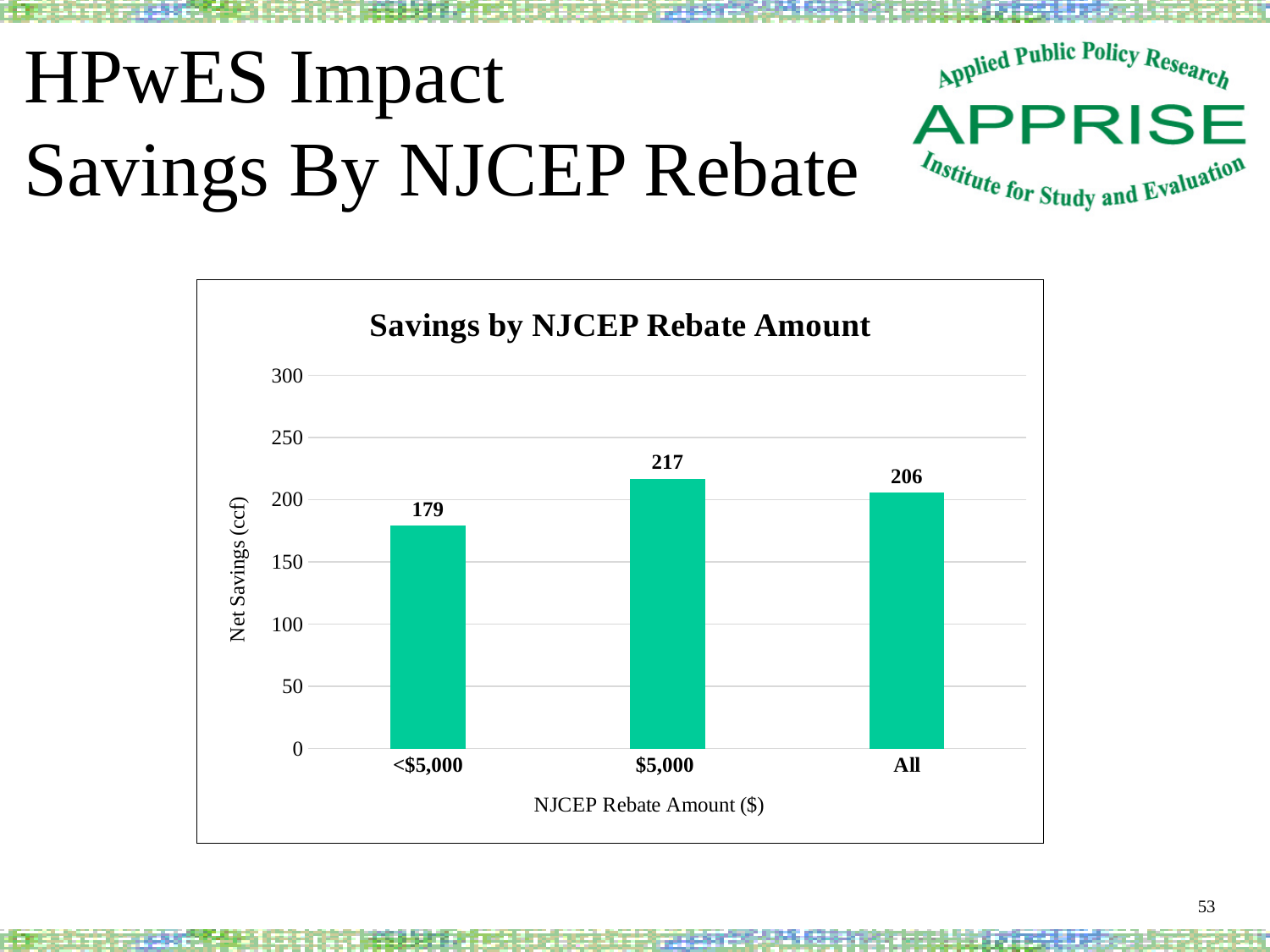
Which rebate category has the highest net savings? $5,000 Which rebate category has the lowest net savings? <$5,000 What is the difference in net savings between the $5,000 category and the All category? 11 What type of chart is shown on the slide? bar chart What is the net savings value for the All category? 206 Which has higher net savings, the <$5,000 category or the All category? All Is the net savings value for the <$5,000 category greater or less than 200? less What is the net savings value for the <$5,000 rebate category? 179 What is the net savings value for the $5,000 rebate category? 217 How many rebate categories are shown on the chart? 3 What is the title of the chart? Savings by NJCEP Rebate Amount What is the difference in net savings between the $5,000 and <$5,000 categories? 38